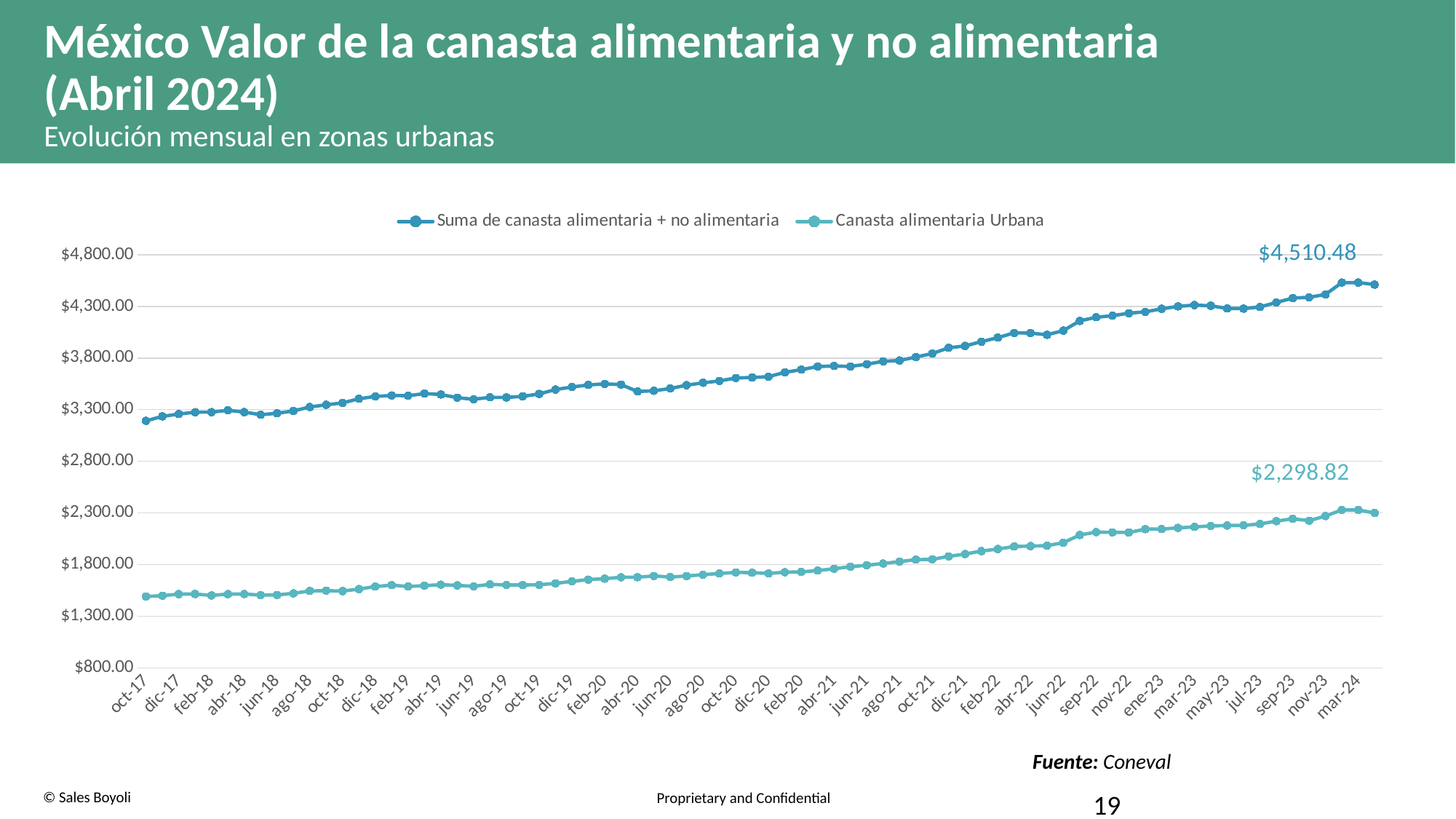
What source is cited below the chart? Coneval What data label is shown at the end of the 'Canasta alimentaria Urbana' series? $2,298.82 What data label is shown at the end of the 'Suma de canasta alimentaria + no alimentaria' series? $4,510.48 What kind of chart is shown on the slide? line chart Is the value of 'Canasta alimentaria Urbana' at sep-22 greater or less than $1,800.00? greater Which series has higher values throughout the chart, 'Suma de canasta alimentaria + no alimentaria' or 'Canasta alimentaria Urbana'? Suma de canasta alimentaria + no alimentaria What is the difference between the two labelled values, $4,510.48 and $2,298.82? $2,211.66 Do the values of 'Canasta alimentaria Urbana' generally rise or fall from oct-17 to mar-24? rise Is the value of 'Suma de canasta alimentaria + no alimentaria' at oct-17 greater or less than $3,300.00? less Is the value of 'Suma de canasta alimentaria + no alimentaria' at mar-24 greater or less than $4,300.00? greater How many series does the legend list? 2